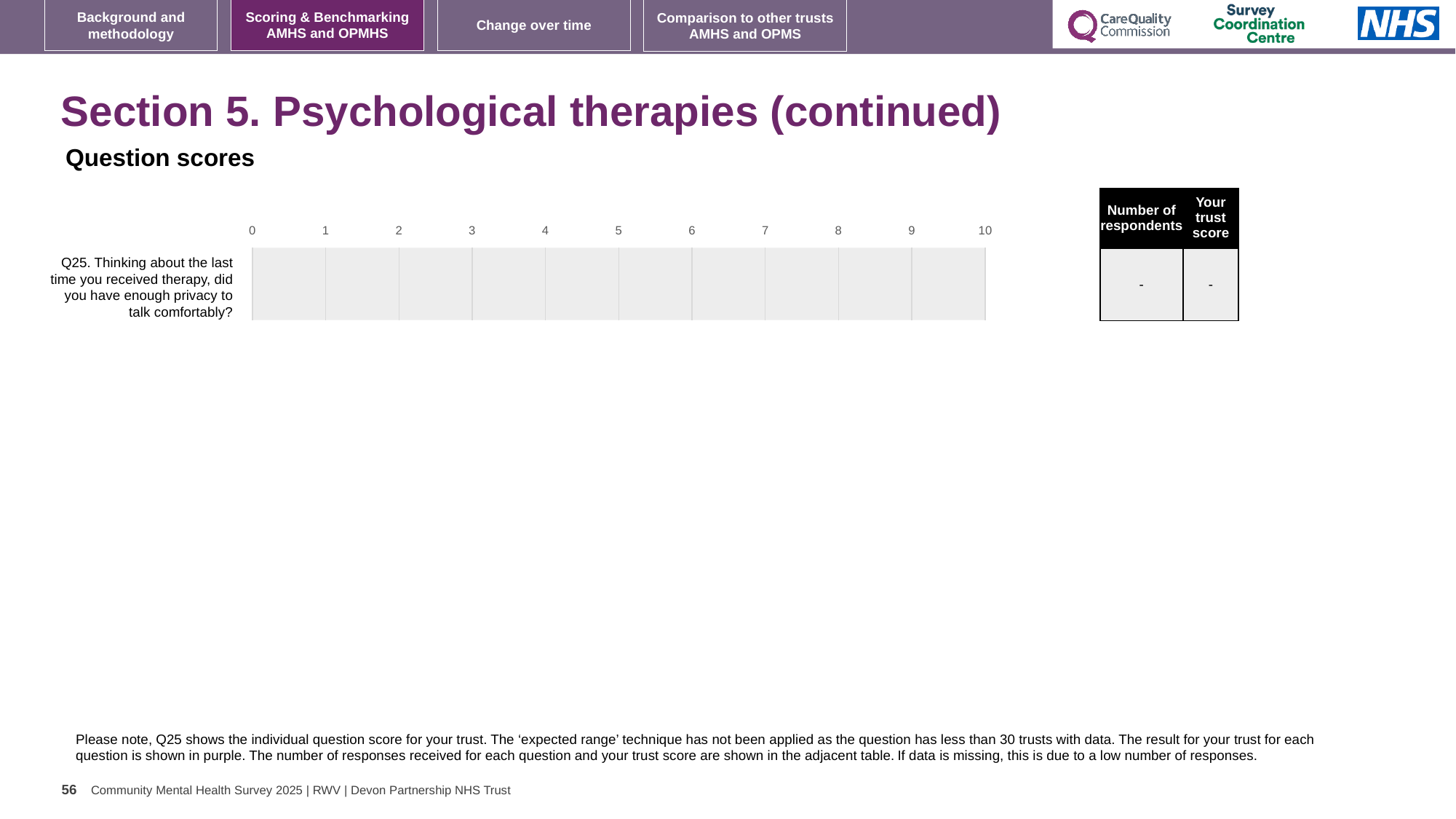
What is the highest value shown on the chart's horizontal axis? 10 What value is shown in the 'Your trust score' column for Q25? - How many questions (categories) are plotted on the chart? 1 Which question number is the single category on the chart? Q25 What value is shown in the 'Number of respondents' column for Q25? - What kind of chart is used to show the Q25 question score? bar chart